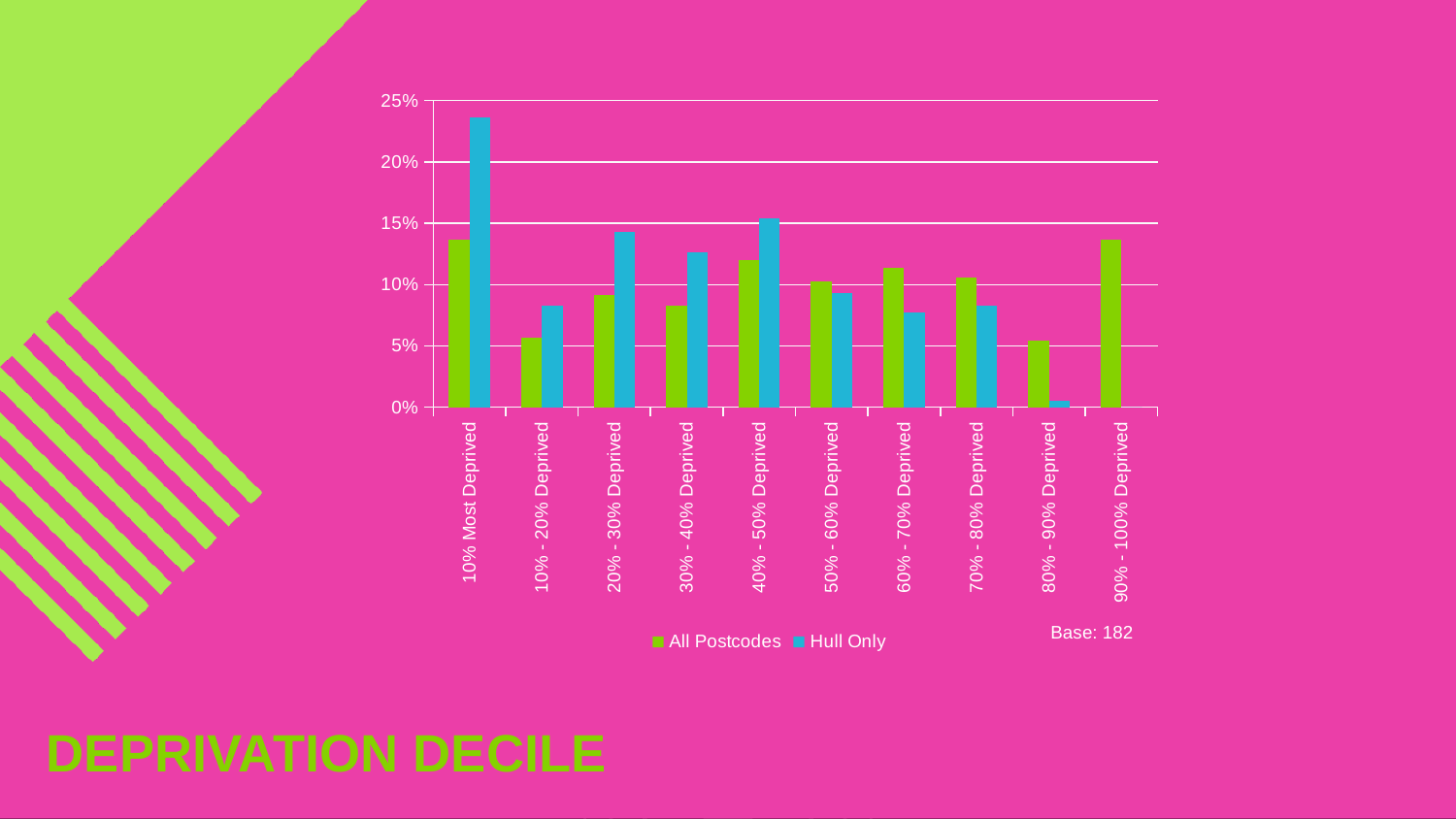
How many series does the legend list? 2 Is the Hull Only value for 10% Most Deprived greater or less than 20%? greater What base size is stated next to the chart? Base: 182 For 60% - 70% Deprived, which series has the larger value, All Postcodes or Hull Only? All Postcodes How many deprivation decile categories are shown on the x axis? 10 Which category has the highest Hull Only value? 10% Most Deprived Is the All Postcodes value for 10% - 20% Deprived greater or less than 10%? less Is the All Postcodes value for 90% - 100% Deprived greater or less than 10%? greater Which series is shown in blue in the legend? Hull Only For 20% - 30% Deprived, which series has the larger value, All Postcodes or Hull Only? Hull Only What kind of chart is shown on the slide? bar chart